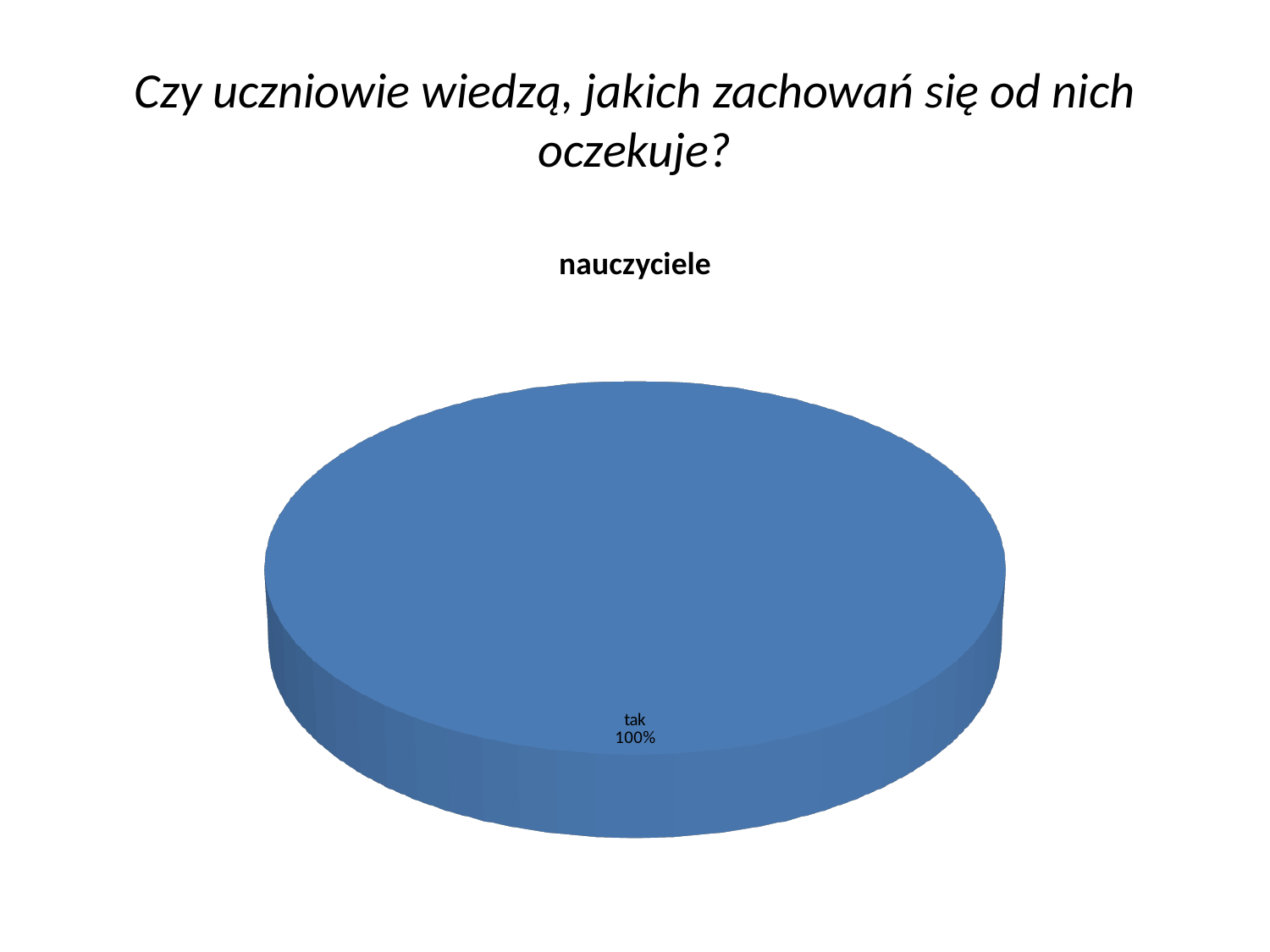
What is the title of the chart? nauczyciele What kind of chart is shown on the slide? pie chart What is the label of the only slice in the pie chart? tak Is the value for "tak" greater or less than 50%? greater What colour is the "tak" slice? blue How many slices does the pie chart have? 1 What share of the pie does the "tak" slice represent? 100%